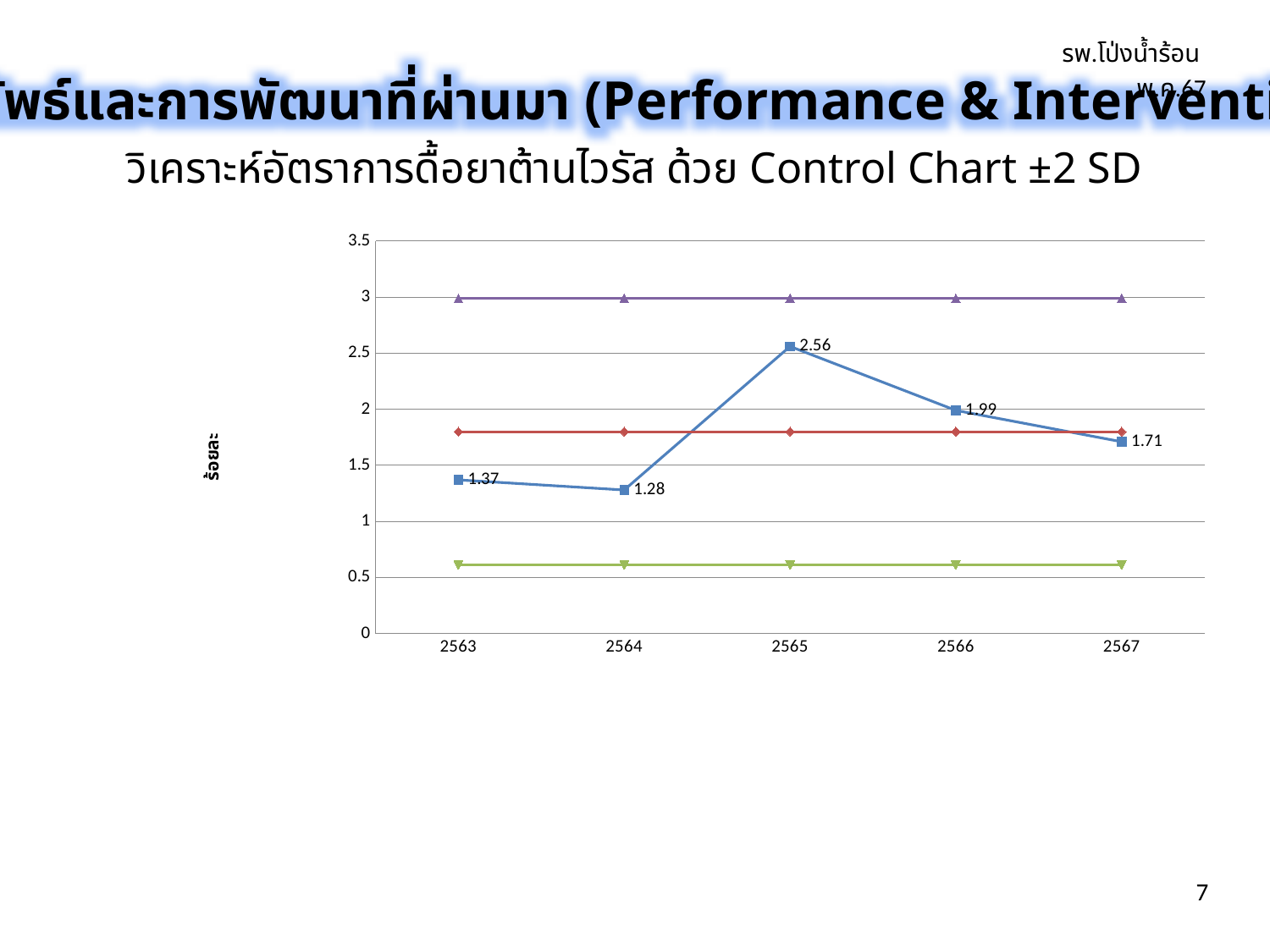
How many years are shown on the x axis? 5 What is the difference between the values for 2565 and 2566? 0.57 Which year has the larger value, 2566 or 2567? 2566 Which year has the highest labelled value? 2565 What is the difference between the values for 2563 and 2564? 0.09 What is the data value for 2567? 1.71 What is the data value for 2563? 1.37 Is the upper control line (purple triangles) greater or less than 2.5? greater What kind of chart is shown on the slide? line chart Which year has the lowest labelled value? 2564 What is the data value for 2565? 2.56 Do the labelled values rise or fall from 2565 to 2567? fall